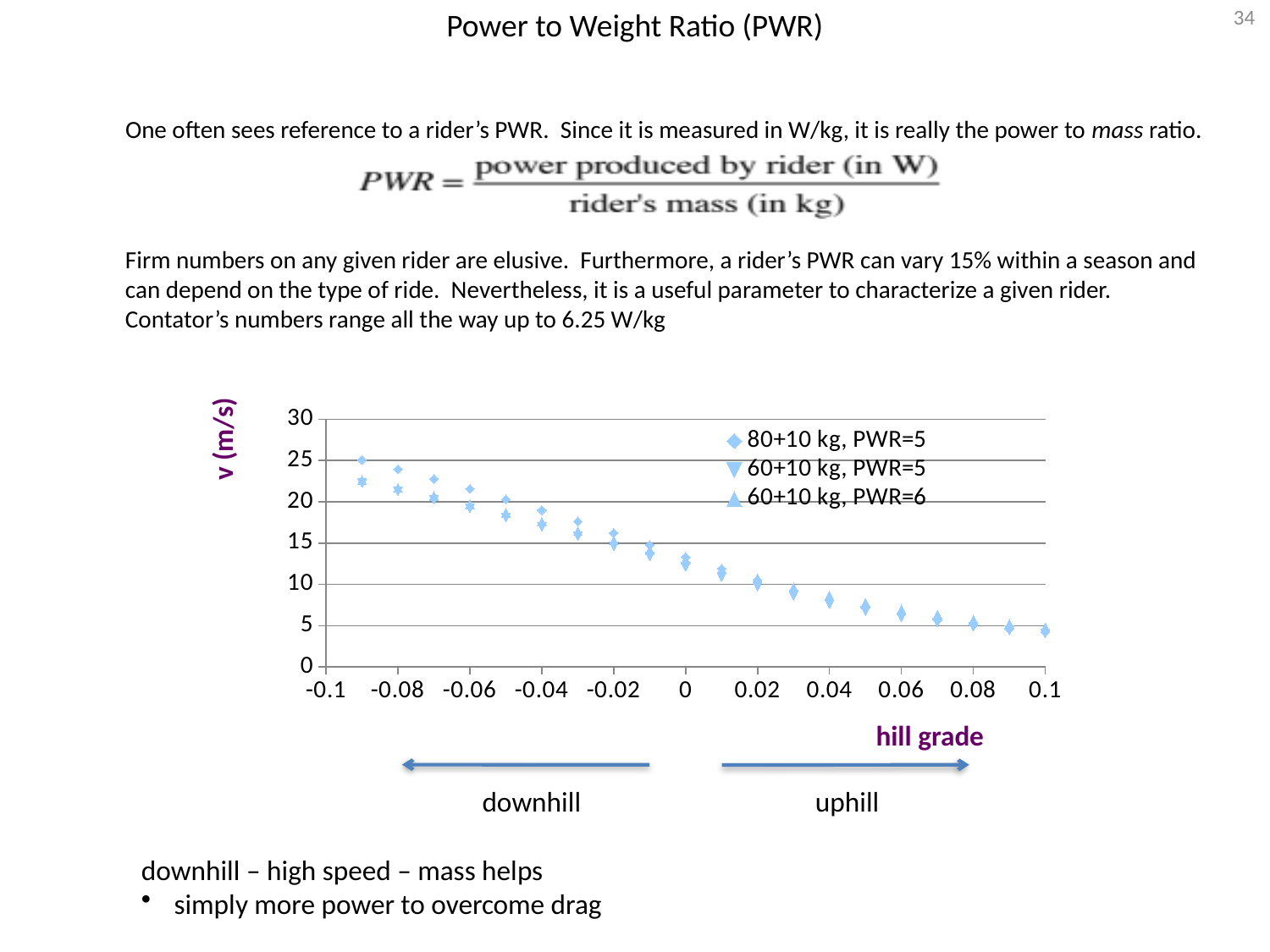
Is the value for 80+10 kg, PWR=5 at hill grade 0 greater or less than 15? less What is the label of the chart's x axis? hill grade How many series does the chart legend list? 3 What kind of chart is shown on the slide? scatter chart Is the value for 80+10 kg, PWR=5 at hill grade 0.06 greater or less than 10? less Do the plotted speeds rise or fall as hill grade increases from -0.1 to 0.1? fall At hill grade -0.08, is the value for 80+10 kg, PWR=5 larger or smaller than the value for 60+10 kg, PWR=5? larger What is the label of the chart's y axis? v (m/s) Is the value for 80+10 kg, PWR=5 at hill grade 0.04 greater or less than 10? less Which series has the highest value at hill grade -0.09? 80+10 kg, PWR=5